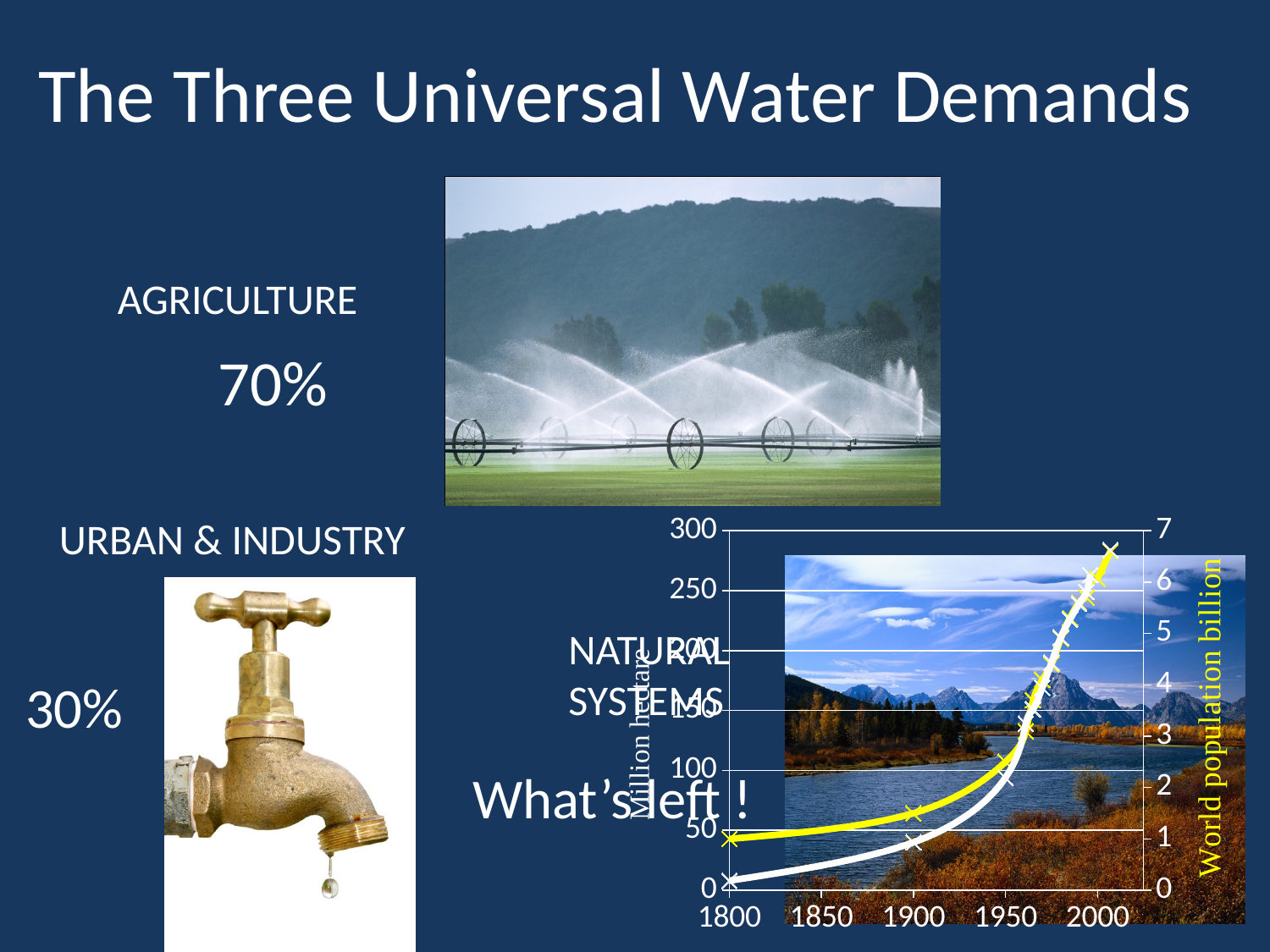
What is the label of the right vertical axis of the bottom-right chart? World population billion How many year labels are shown on the x axis of the bottom-right chart? 5 In the bottom-right chart, does the yellow line rise or fall from 1800 to 2000? rise In the bottom-right chart, does the white line rise or fall from 1800 to 2000? rise What is the first year shown on the x axis of the bottom-right chart? 1800 What is the maximum value shown on the left vertical axis of the bottom-right chart? 300 What kind of chart is shown at the bottom right of the slide? line chart